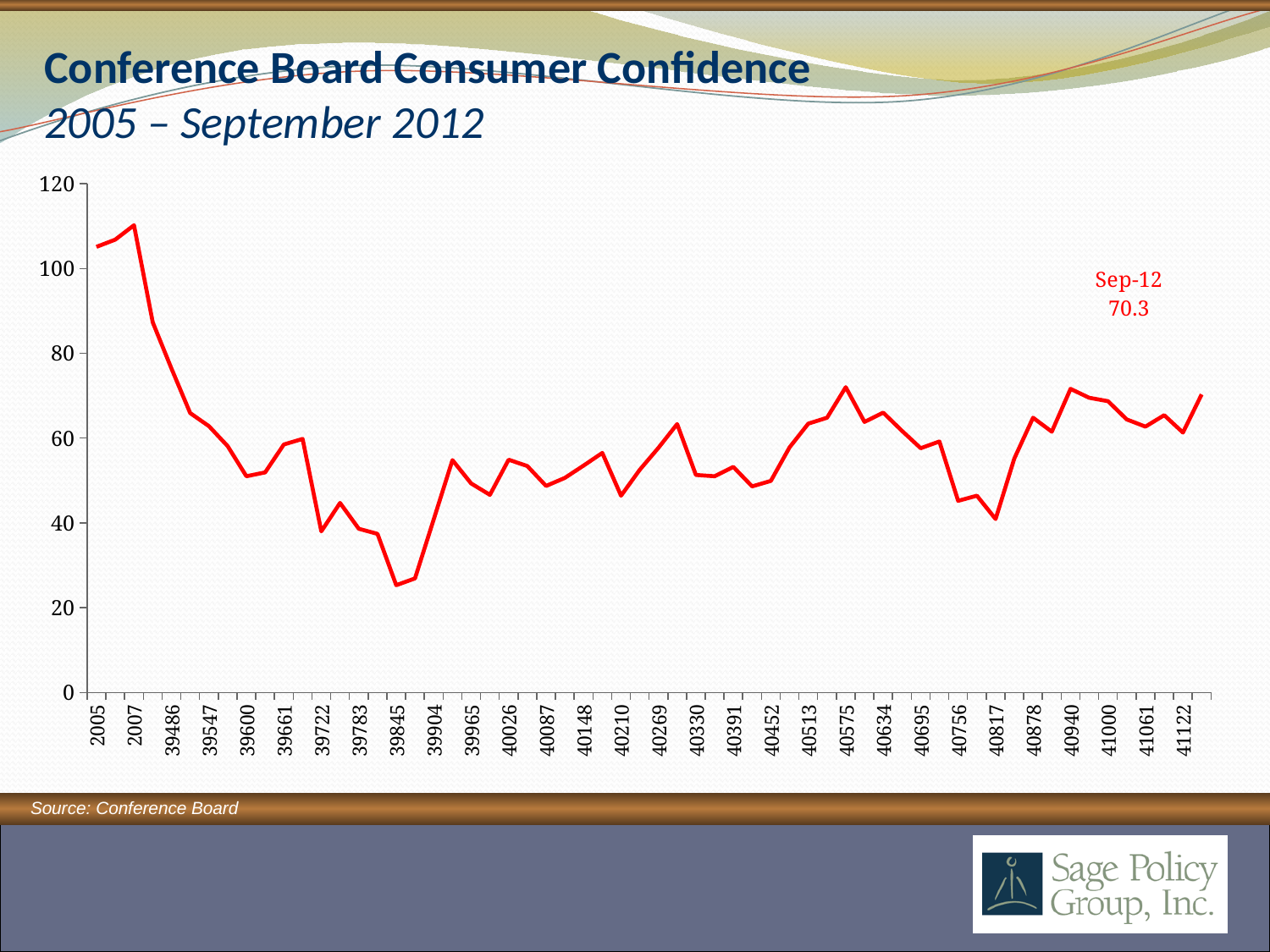
Is the value at the 39845 x-axis label greater or less than 40? less What is the consumer confidence value labelled for Sep-12? 70.3 Is the value at the 2007 x-axis label greater or less than 100? greater At which x-axis label does the line reach its highest point? 2007 What kind of chart is shown on the slide? line chart Is the value at the 2005 x-axis label greater or less than 100? greater What is the highest value shown on the y-axis? 120 Near which x-axis label does the line reach its lowest point? 39845 Which is larger, the value at 2007 or the value at Sep-12? 2007 Does the line rise or fall between the 2007 label and the 39845 label? fall What is the title of the chart? Conference Board Consumer Confidence 2005 – September 2012